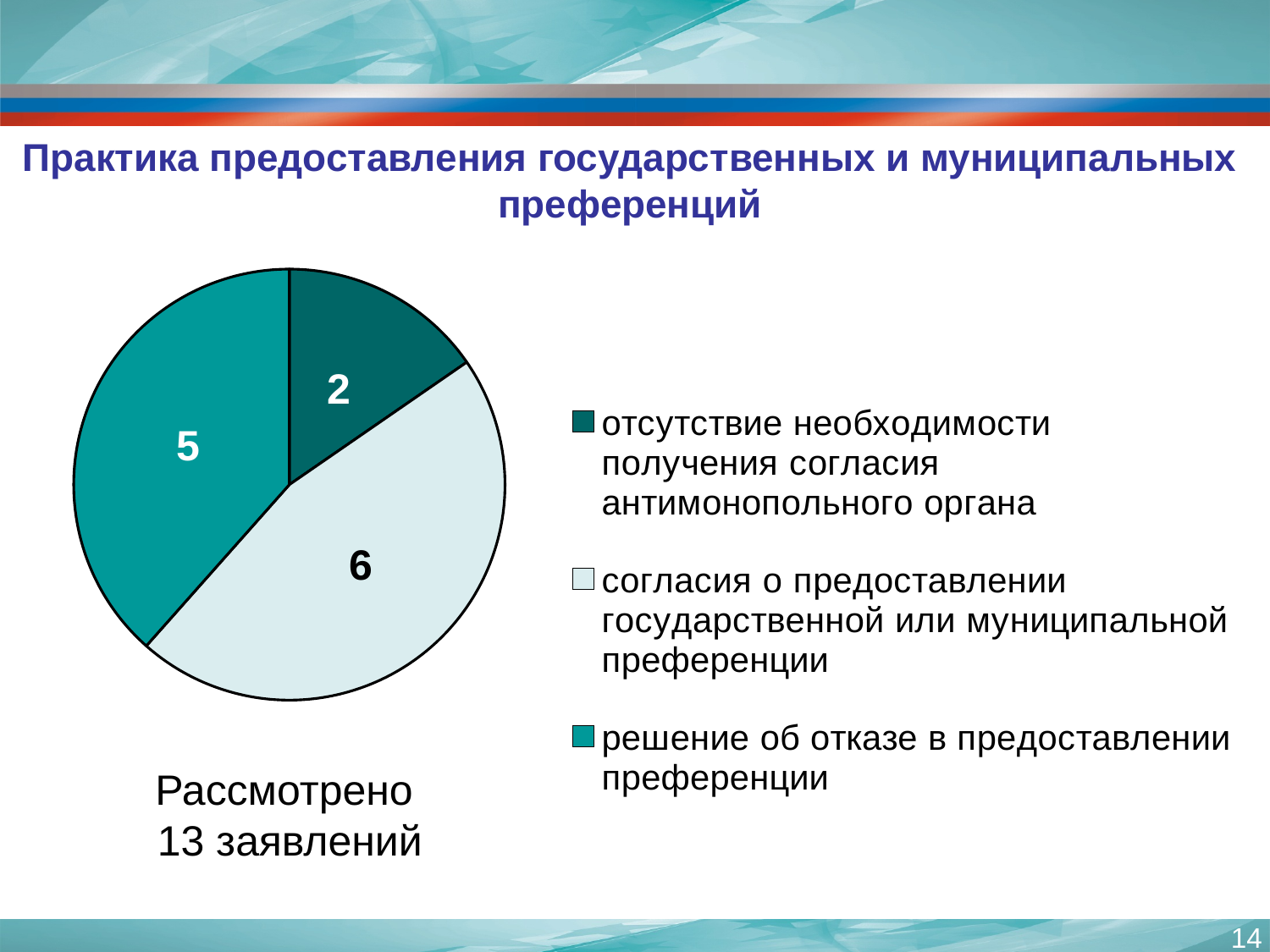
Which is larger: the value for "решение об отказе в предоставлении преференции" or the value for "отсутствие необходимости получения согласия антимонопольного органа"? решение об отказе в предоставлении преференции What is the value for "отсутствие необходимости получения согласия антимонопольного органа"? 2 What is the difference between the value for "согласия о предоставлении государственной или муниципальной преференции" and the value for "решение об отказе в предоставлении преференции"? 1 What is the title of the slide containing the pie chart? Практика предоставления государственных и муниципальных преференций How many entries does the legend list? 3 Which category has the largest slice of the pie? согласия о предоставлении государственной или муниципальной преференции What is the total of all slices in the pie chart? 13 Which category has the smallest slice of the pie? отсутствие необходимости получения согласия антимонопольного органа What is the value for "согласия о предоставлении государственной или муниципальной преференции"? 6 What kind of chart is shown on the slide? pie chart How many slices does the pie chart have? 3 What is the value for "решение об отказе в предоставлении преференции"? 5